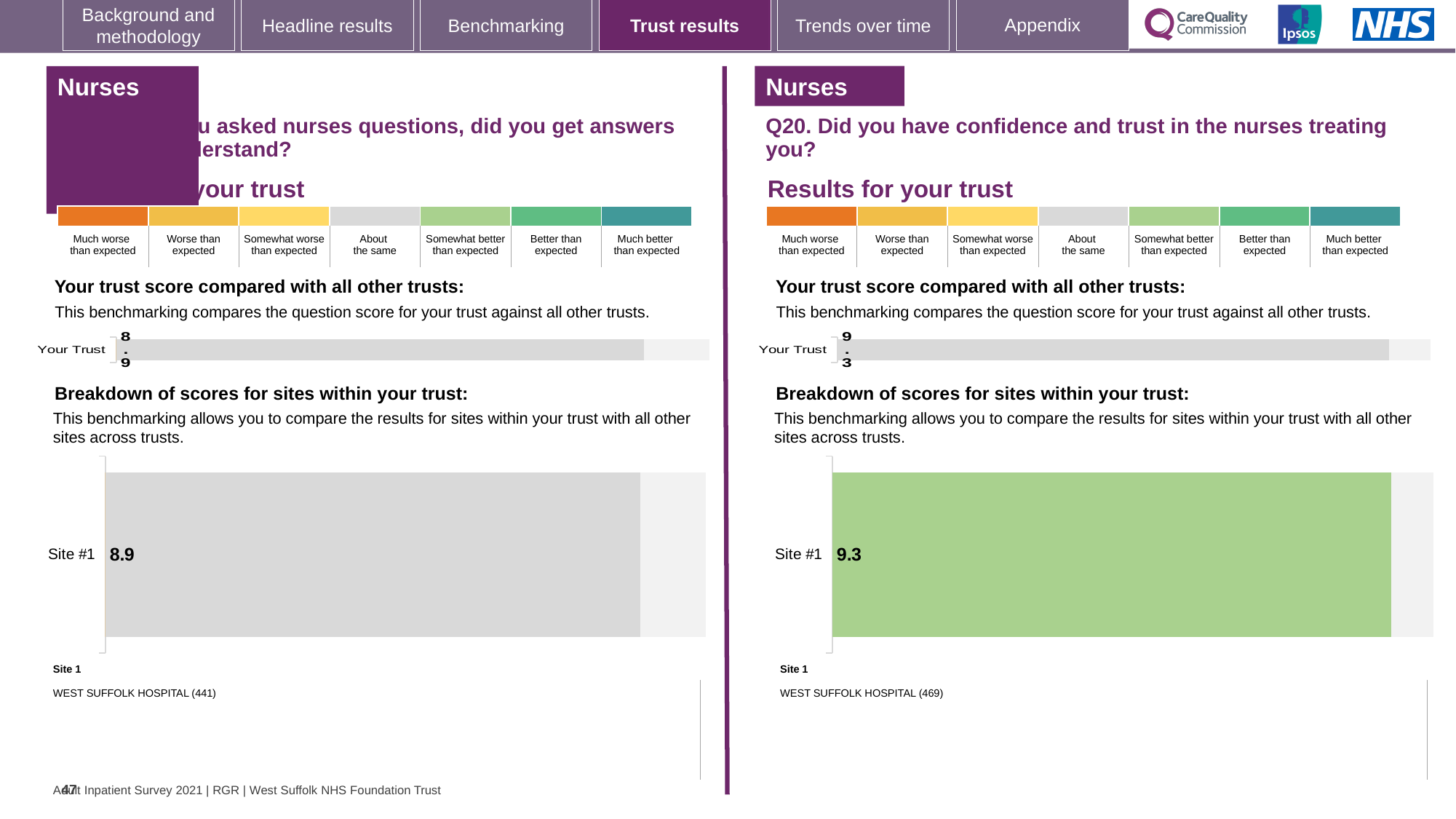
What kind of chart is used to show the Site #1 score on the right panel (Q20)? Bar chart On the right panel (Q20), what is the score shown for Your Trust? 9.3 Which site name is listed as Site 1 on the right panel (Q20)? WEST SUFFOLK HOSPITAL (469) What colour is the Site #1 bar on the left panel? Grey How many sites are shown in the site breakdown chart on the left panel? 1 What colour is the Site #1 bar on the right panel (Q20)? Green On the left panel, what is the score shown for Site #1? 8.9 What is the difference between the Site #1 score on the right panel (Q20) and the Site #1 score on the left panel? 0.4 On the right panel (Q20), what is the score shown for Site #1? 9.3 On the left panel, what is the score shown for Your Trust? 8.9 How many sites are shown in the site breakdown chart on the right panel (Q20)? 1 Which Site #1 score is larger: the left panel's or the right panel's (Q20)? Right panel (Q20)